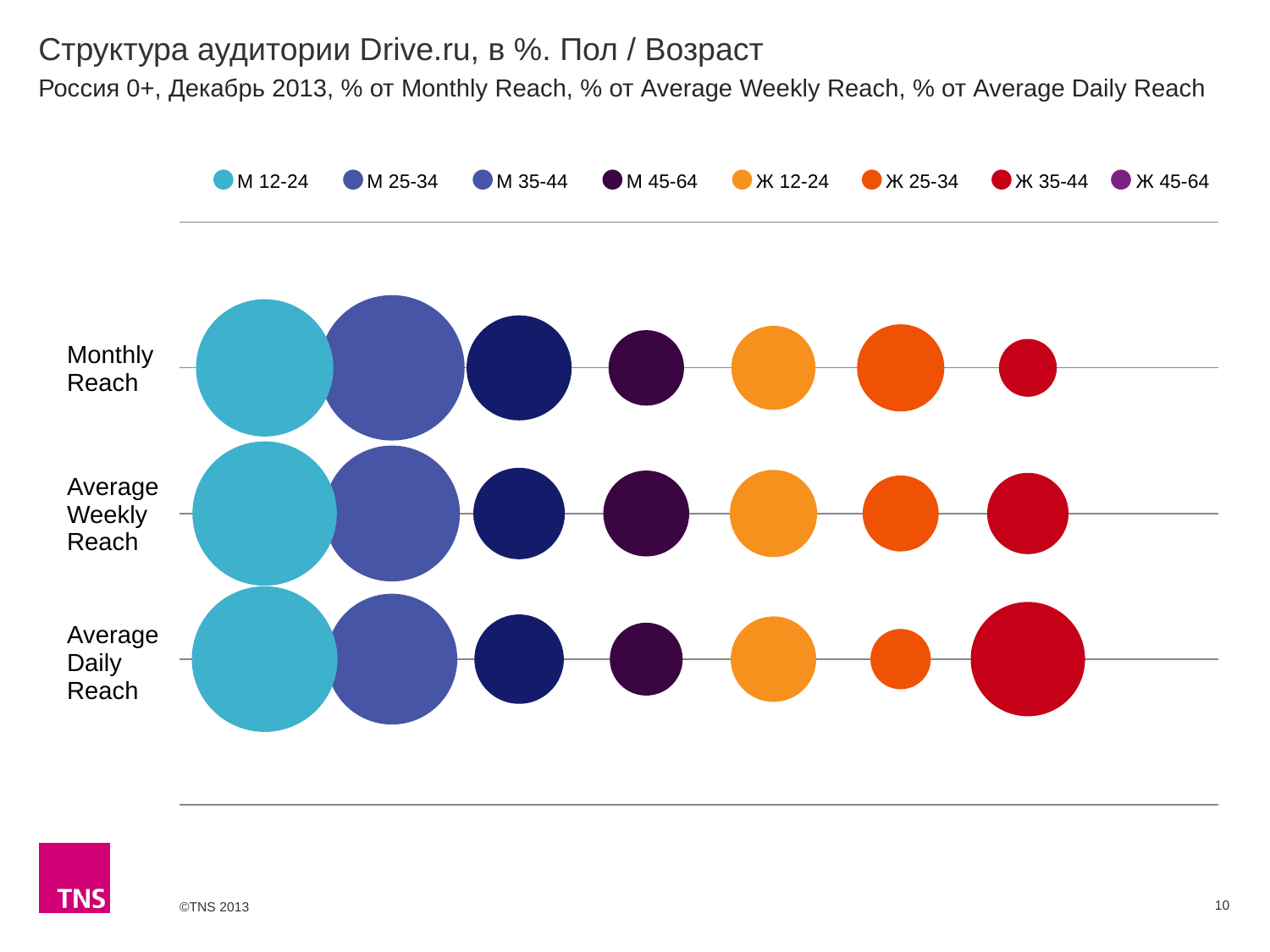
In the Monthly Reach row, which bubble is larger: М 12-24 or М 45-64? М 12-24 What kind of chart is shown on the slide? bubble chart In the Monthly Reach row, which bubble is larger: М 25-34 or Ж 35-44? М 25-34 How many reach categories (rows) are plotted on the chart? 3 Which series is listed last in the legend? Ж 45-64 In the Average Weekly Reach row, which bubble is larger: М 25-34 or Ж 25-34? М 25-34 In the Monthly Reach row, which of the visible bubbles is the smallest? Ж 35-44 How many series does the legend list? 8 Which series is listed first in the legend? М 12-24 Does the Ж 25-34 bubble get larger or smaller going from Monthly Reach to Average Daily Reach? smaller Does the Ж 35-44 bubble get larger or smaller going from Monthly Reach to Average Daily Reach? larger